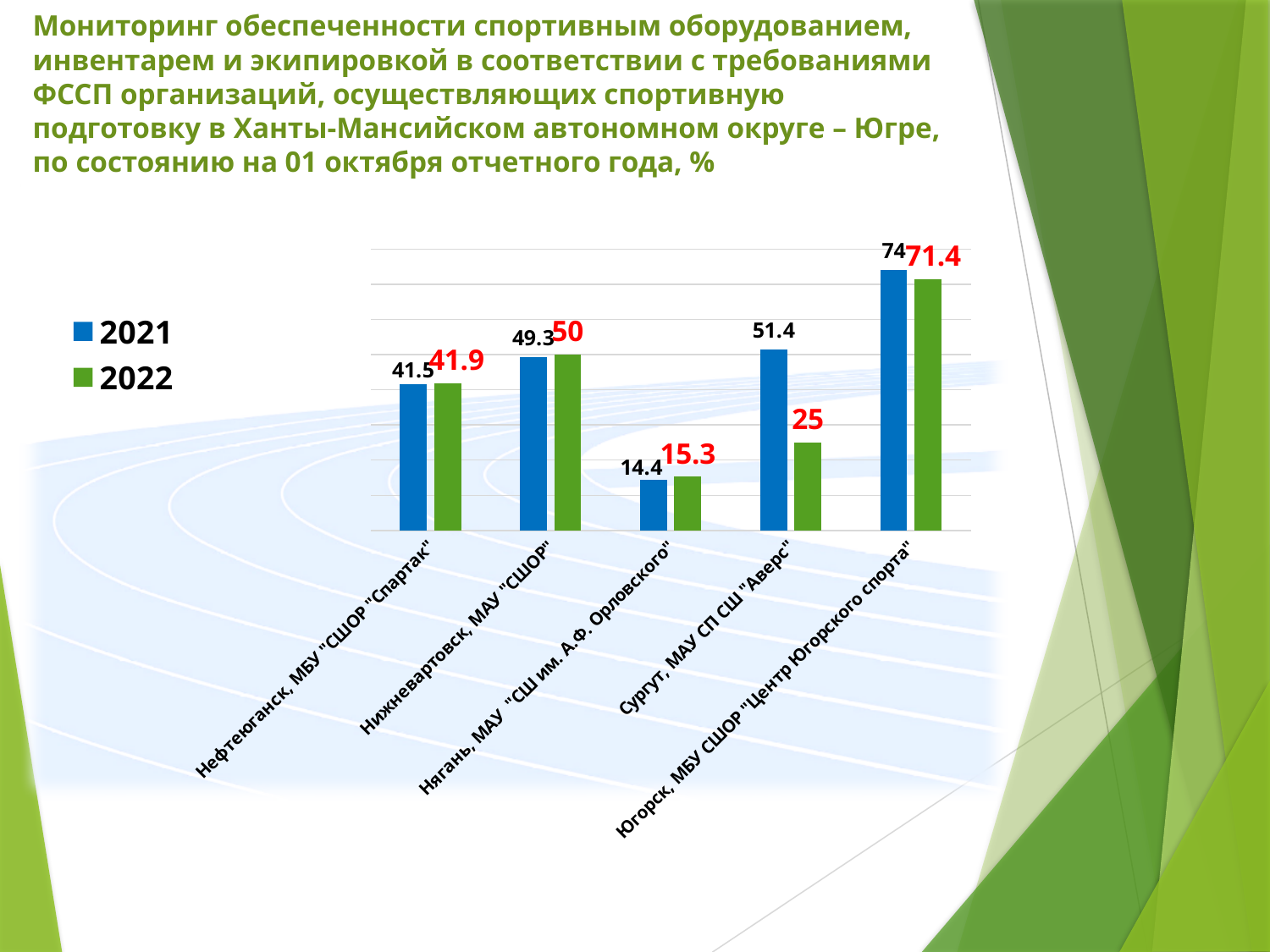
How many series does the legend list? 2 Which organisation has the lowest 2022 value? Нягань, МАУ "СШ им. А.Ф. Орловского" What is the 2022 value for Нижневартовск, МАУ "СШОР"? 50 Which colour represents the 2022 series in the legend? Green What kind of chart is shown on the slide? Bar chart What is the 2021 value for Нефтеюганск, МБУ "СШОР "Спартак"? 41.5 Which organisation has the highest 2021 value? Югорск, МБУ СШОР "Центр Югорского спорта" How many organisations are shown on the x axis? 5 What is the 2021 value for Сургут, МАУ СП СШ "Аверс"? 51.4 What is the 2022 value for Нягань, МАУ "СШ им. А.Ф. Орловского"? 15.3 For Югорск, МБУ СШОР "Центр Югорского спорта", which year has the larger value, 2021 or 2022? 2021 What is the difference between the 2021 and 2022 values for Сургут, МАУ СП СШ "Аверс"? 26.4